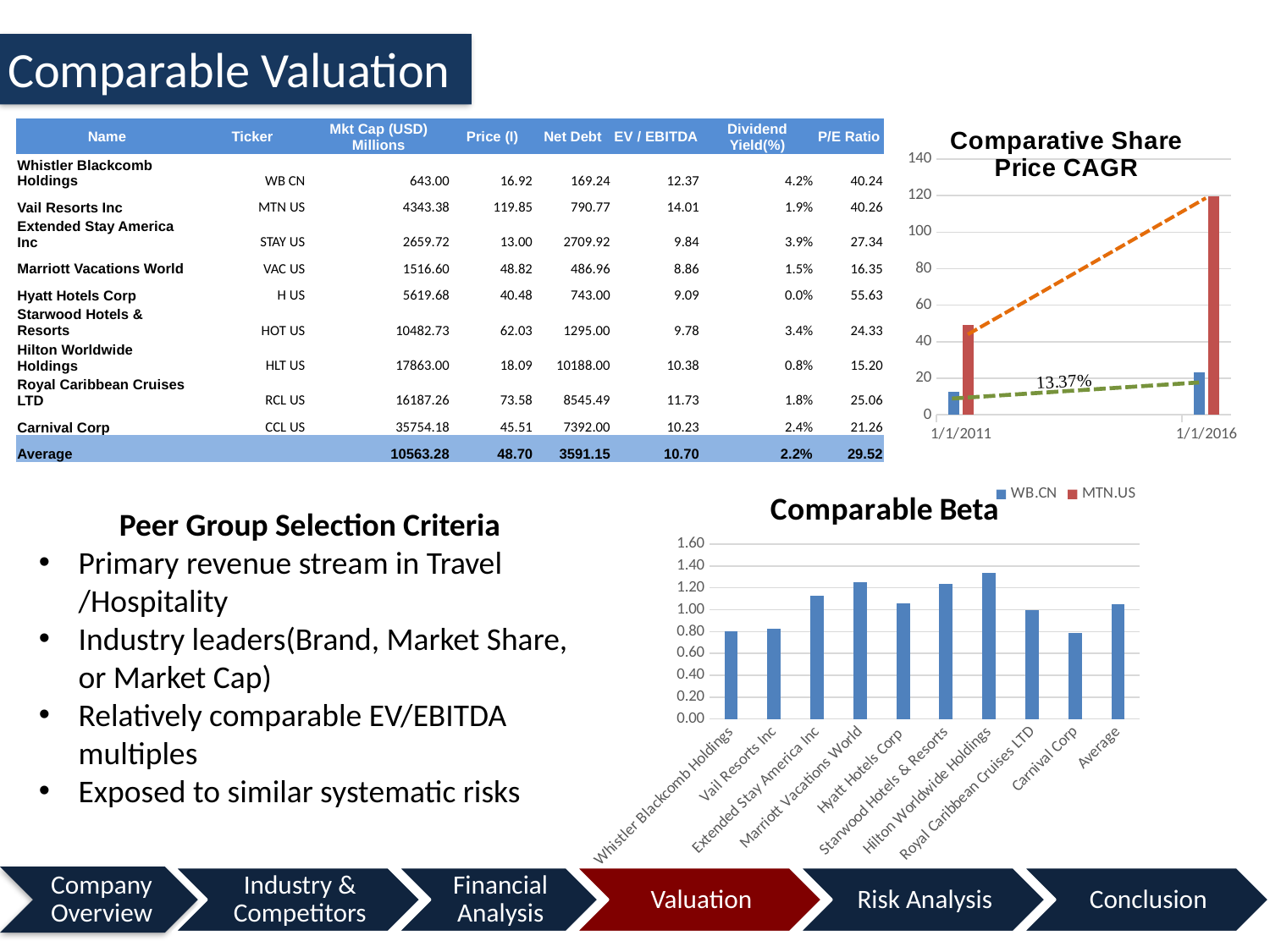
In the Comparable Beta chart, is the value for Hilton Worldwide Holdings greater or less than 1.20? greater What percentage label is printed on the Comparative Share Price CAGR chart? 13.37% In the Comparable Beta chart, which category has the highest beta? Hilton Worldwide Holdings In the Comparative Share Price CAGR chart, is the value for WB.CN at 1/1/2011 greater or less than 20? less In the Comparative Share Price CAGR chart, is the value for MTN.US at 1/1/2016 greater or less than 100? greater How many categories are shown on the x axis of the Comparable Beta chart? 10 In the Comparable Beta chart, which is larger, the value for Marriott Vacations World or the value for Hyatt Hotels Corp? Marriott Vacations World What type of chart is the Comparable Beta chart? bar chart In the Comparable Beta chart, which is larger, the value for Hilton Worldwide Holdings or the value for Vail Resorts Inc? Hilton Worldwide Holdings What is the highest value shown on the y axis of the Comparable Beta chart? 1.60